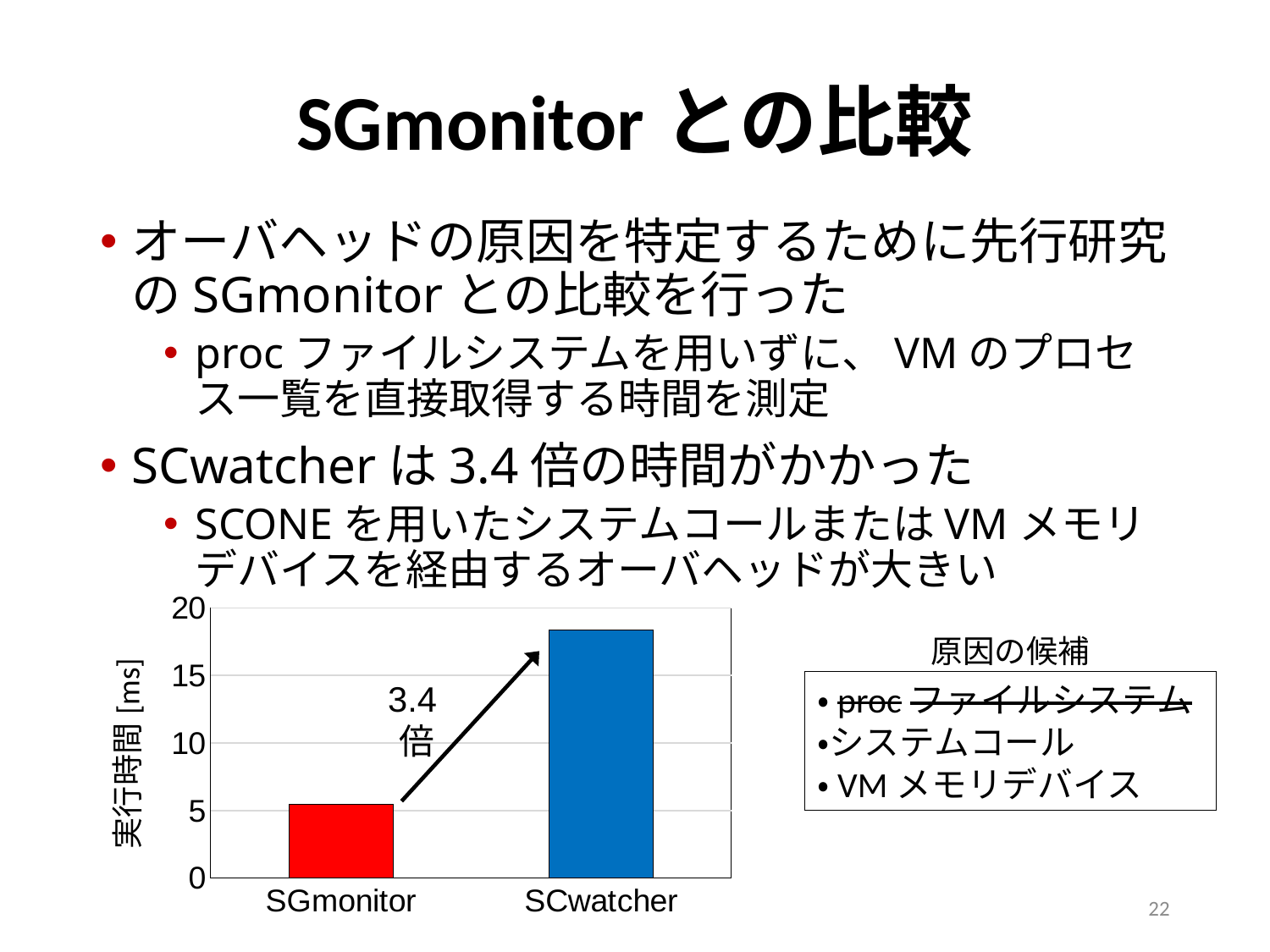
What kind of chart is shown on the slide? bar chart Is the value for SGmonitor greater or less than 10? less Which is larger, the value for SGmonitor or the value for SCwatcher? SCwatcher What is the label of the y axis of the chart? 実行時間 [ms] Which category has the lowest execution time in the chart? SGmonitor Is the value for SCwatcher greater or less than 20? less Is the value for SCwatcher greater or less than 15? greater How many bars are plotted in the chart? 2 Which category has the highest execution time in the chart? SCwatcher What is the highest tick value shown on the y axis of the chart? 20 What ratio is written on the arrow between the two bars in the chart? 3.4倍